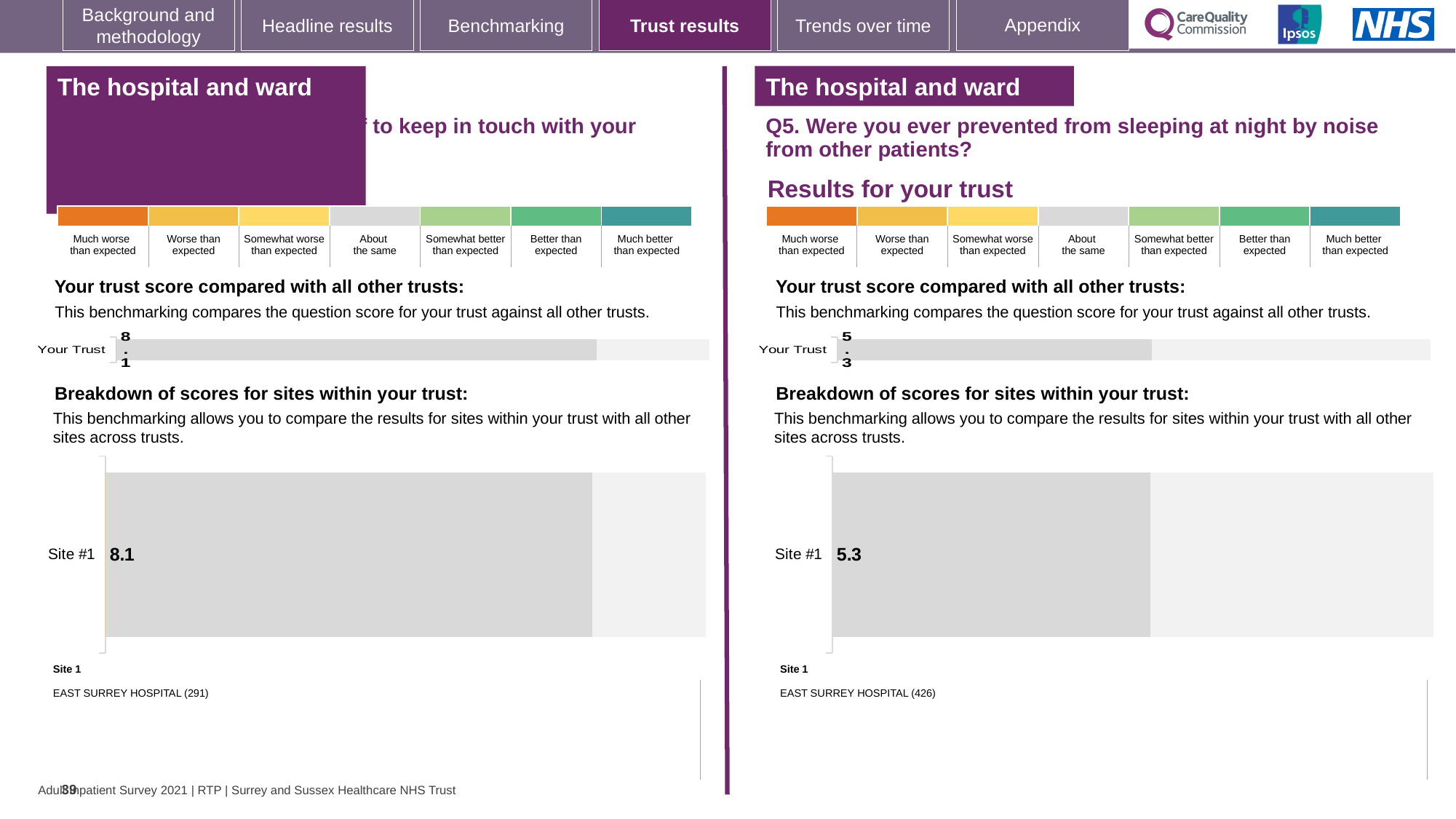
In the left panel's 'Your trust score compared with all other trusts' chart, what is the score for Your Trust? 8.1 What is the difference between the Site #1 score in the left panel (8.1) and the Site #1 score in the right panel (5.3)? 2.8 How many rating categories are shown in the colour scale above the right panel (Q5) charts, from 'Much worse than expected' to 'Much better than expected'? 7 In the right panel (Q5), which hospital is listed as Site 1 below the breakdown chart? EAST SURREY HOSPITAL (426) In the right panel (Q5) 'Breakdown of scores for sites within your trust' chart, what is the score for Site #1? 5.3 In the right panel (Q5) 'Your trust score compared with all other trusts' chart, what is the score for Your Trust? 5.3 How many sites are shown in the left panel's 'Breakdown of scores for sites within your trust' chart? 1 Comparing the Site #1 bars, which panel shows the higher score: the left panel or the right panel (Q5)? left panel Comparing the Your Trust bars, which panel shows the lower score: the left panel or the right panel (Q5)? right panel (Q5) What kind of chart is used to show the Site #1 score in the right panel (Q5)? bar chart How many sites are shown in the right panel (Q5) 'Breakdown of scores for sites within your trust' chart? 1 In the left panel's 'Breakdown of scores for sites within your trust' chart, what is the score for Site #1? 8.1